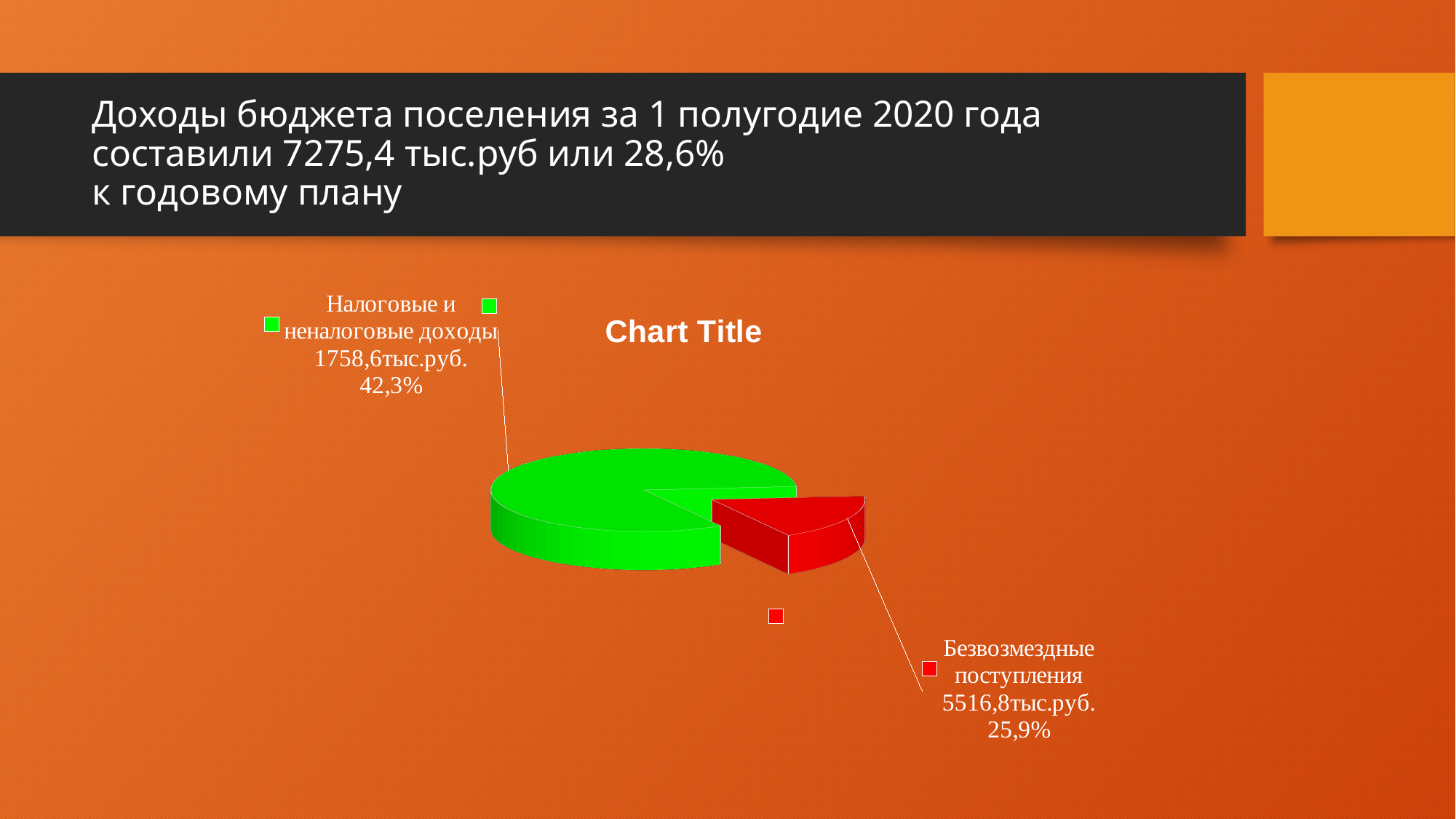
What is the title printed above the pie chart? Chart Title What kind of chart is shown on the slide? pie chart What is the difference in тыс.руб. between the labelled values for Безвозмездные поступления and Налоговые и неналоговые доходы? 3758,2 тыс.руб. What is the sum in тыс.руб. of the two labelled values on the pie chart? 7275,4 тыс.руб. What value in тыс.руб. is labelled for Безвозмездные поступления? 5516,8тыс.руб. What percentage is printed in the data label for Безвозмездные поступления? 25,9% How many slices does the pie chart have? 2 According to the data labels, which category has the larger value in тыс.руб.: Налоговые и неналоговые доходы or Безвозмездные поступления? Безвозмездные поступления What percentage is printed in the data label for Налоговые и неналоговые доходы? 42,3% What value in тыс.руб. is labelled for Налоговые и неналоговые доходы? 1758,6тыс.руб. What colour is the slice for Безвозмездные поступления? red